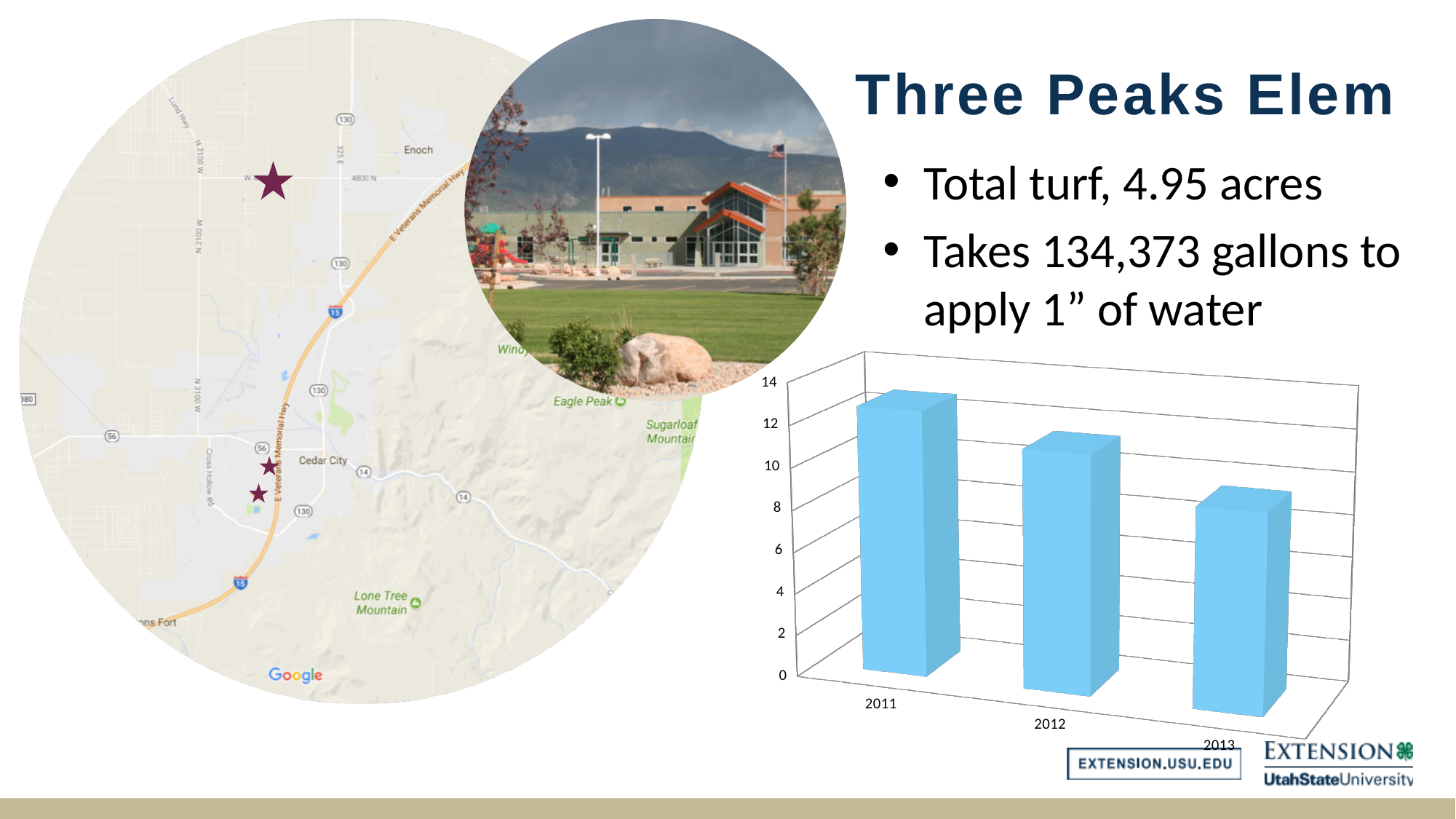
Is the value for 2013 greater or less than 6? greater What is the highest value shown on the chart's vertical axis? 14 How many years are plotted on the x axis of the chart? 3 Is the value for 2012 greater or less than 8? greater What kind of chart is shown on the slide? bar chart Is the value for 2013 greater or less than 10? less Which is larger in the chart, the value for 2012 or the value for 2013? 2012 Which year has the lowest bar in the chart? 2013 Which is larger in the chart, the value for 2011 or the value for 2013? 2011 Do the values rise or fall from 2011 to 2013 in the chart? fall Which year has the highest bar in the chart? 2011